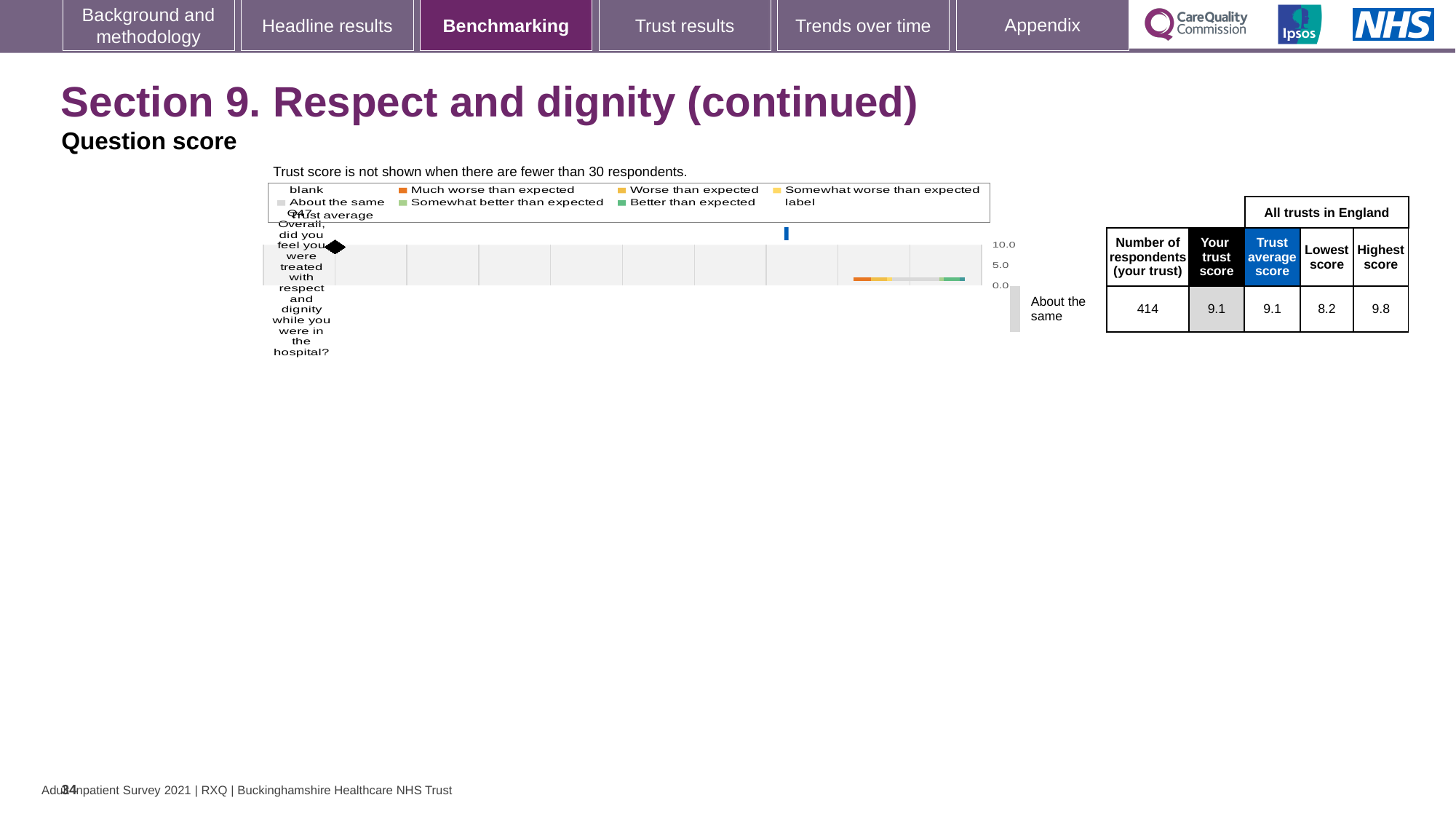
What is the trust average score for Q47? 9.1 Which question number is plotted on the chart? Q47 Is your trust score for Q47 greater or less than 5.0? greater What is the difference between the highest score and the lowest score for Q47? 1.6 How many survey questions are plotted on the chart? 1 What kind of chart is shown on the slide? bar chart What is the highest tick value shown on the chart's score axis? 10.0 What is your trust score for Q47? 9.1 Which is larger for Q47, the highest score or the lowest score? Highest score What is the highest score among all trusts in England for Q47? 9.8 What is the lowest score among all trusts in England for Q47? 8.2 What is the number of respondents for your trust for Q47? 414